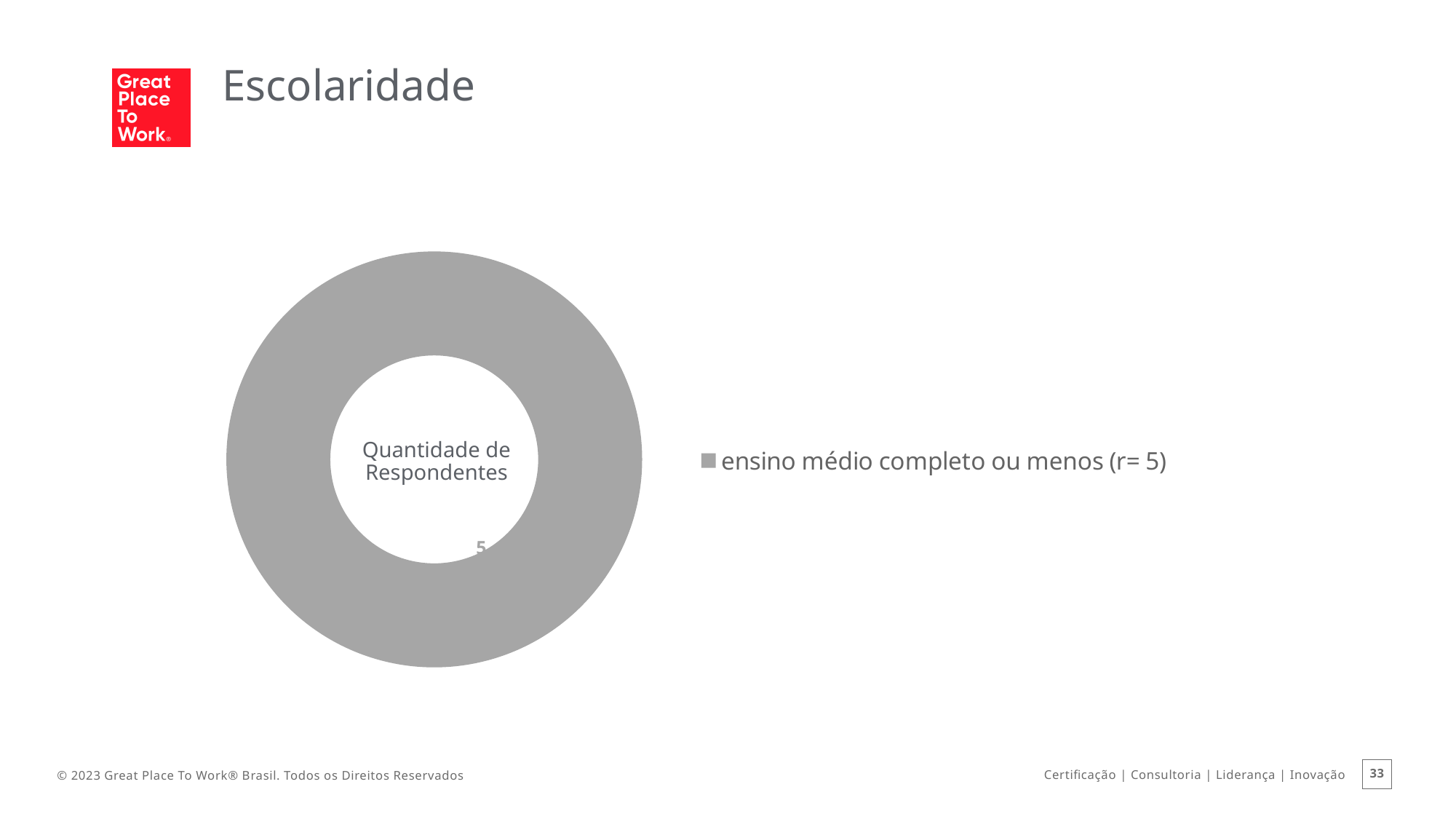
What text appears in the centre of the doughnut chart? Quantidade de Respondentes What share of the doughnut does "ensino médio completo ou menos" occupy? 100% Which category has the highest value in the chart? ensino médio completo ou menos What is the total number of respondents shown in the chart? 5 What is the legend entry of the chart? ensino médio completo ou menos (r= 5) What kind of chart is shown on the slide? doughnut chart How many categories does the legend list? 1 What is the value shown for "ensino médio completo ou menos"? 5